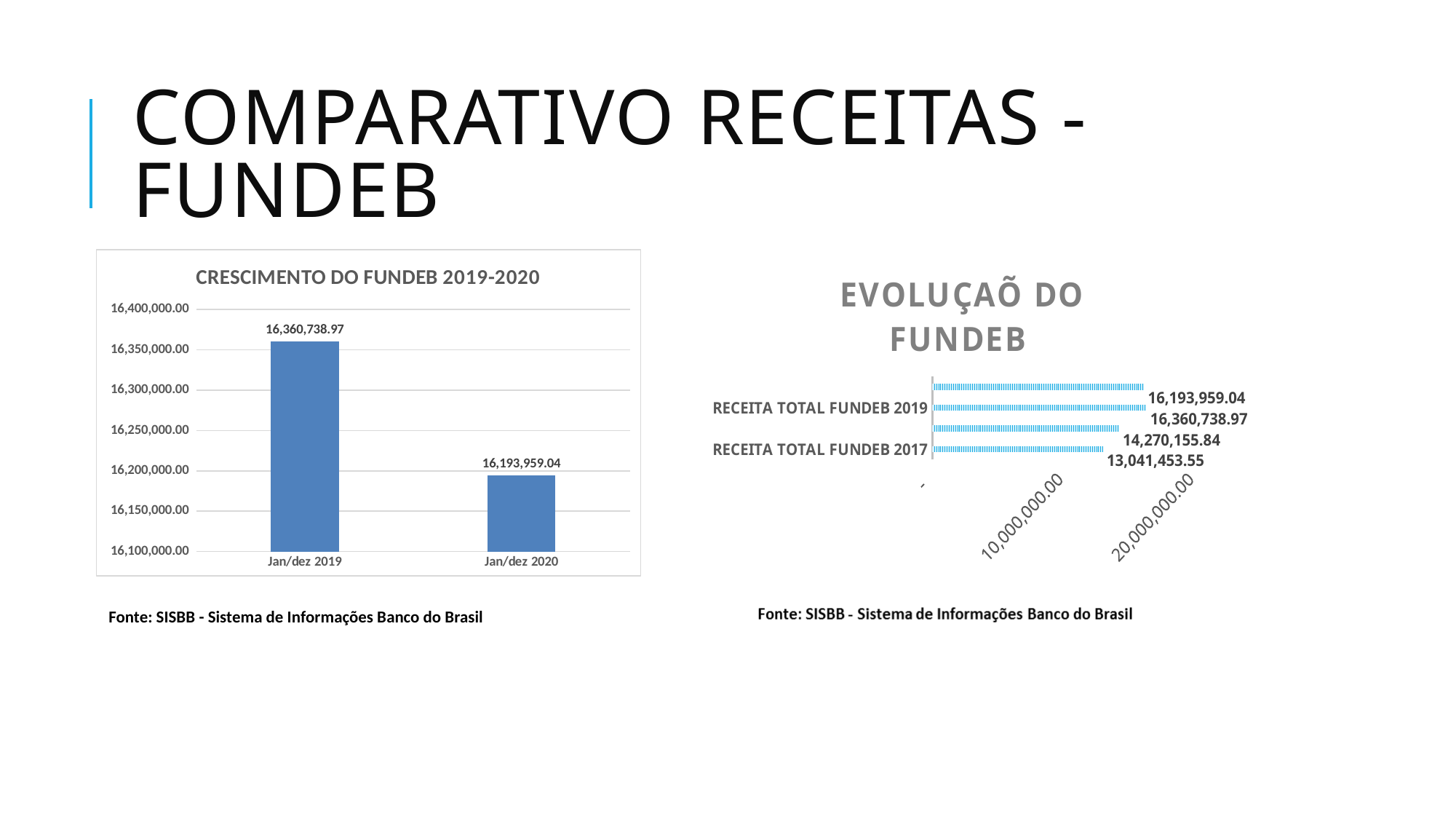
How many bars are shown in the chart titled CRESCIMENTO DO FUNDEB 2019-2020? 2 In the chart titled CRESCIMENTO DO FUNDEB 2019-2020, what is the value for Jan/dez 2020? 16,193,959.04 How many bars are shown in the chart titled EVOLUÇAÕ DO FUNDEB? 4 In the chart titled CRESCIMENTO DO FUNDEB 2019-2020, do the values rise or fall from Jan/dez 2019 to Jan/dez 2020? fall In the chart titled CRESCIMENTO DO FUNDEB 2019-2020, what is the value for Jan/dez 2019? 16,360,738.97 In the chart titled CRESCIMENTO DO FUNDEB 2019-2020, what is the difference between the Jan/dez 2019 and Jan/dez 2020 values? 166,779.93 In the chart titled CRESCIMENTO DO FUNDEB 2019-2020, which category has the higher value? Jan/dez 2019 In the chart titled EVOLUÇAÕ DO FUNDEB, what is the value for RECEITA TOTAL FUNDEB 2017? 13,041,453.55 In the chart titled EVOLUÇAÕ DO FUNDEB, what is the value for RECEITA TOTAL FUNDEB 2019? 16,360,738.97 In the chart titled EVOLUÇAÕ DO FUNDEB, what is the difference between RECEITA TOTAL FUNDEB 2019 and RECEITA TOTAL FUNDEB 2017? 3,319,285.42 What kind of chart is the chart titled CRESCIMENTO DO FUNDEB 2019-2020? bar chart In the chart titled EVOLUÇAÕ DO FUNDEB, is the value for RECEITA TOTAL FUNDEB 2017 greater or less than 10,000,000.00? greater